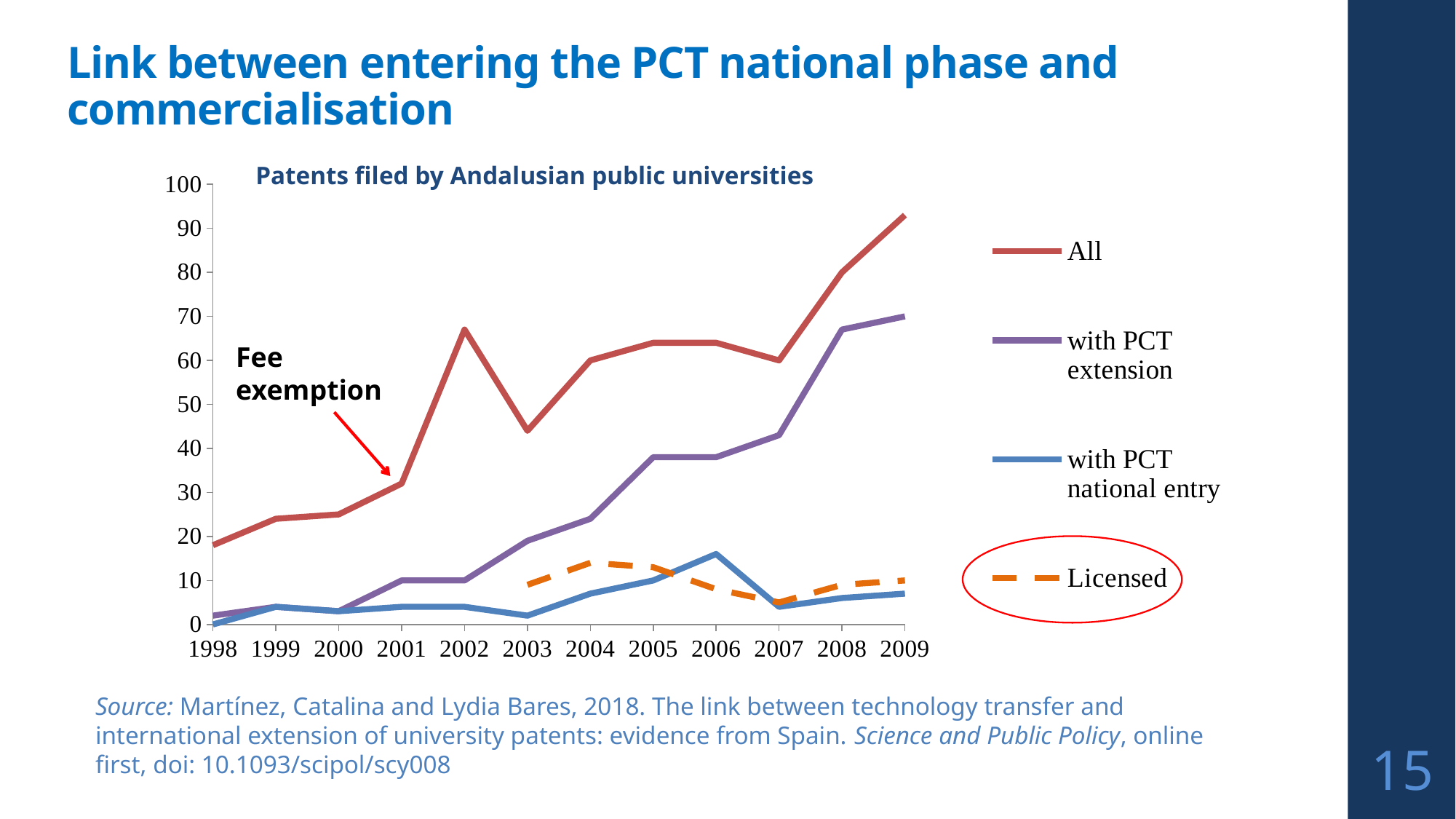
In which year is the 'All' series at its lowest? 1998 How many series does the legend list? 4 How many years are shown on the x axis? 12 In 2006, which is larger: 'with PCT national entry' or 'Licensed'? with PCT national entry Is the value for 'All' in 2009 greater or less than 80? greater What kind of chart is shown on the slide? line chart Is the value for 'with PCT extension' in 2009 greater or less than 60? greater In which year is the 'All' series at its highest? 2009 Is the value for 'All' in 2002 greater or less than 60? greater Which series is drawn with a dashed line? Licensed Does the 'with PCT extension' series rise or fall from 2003 to 2009? rise